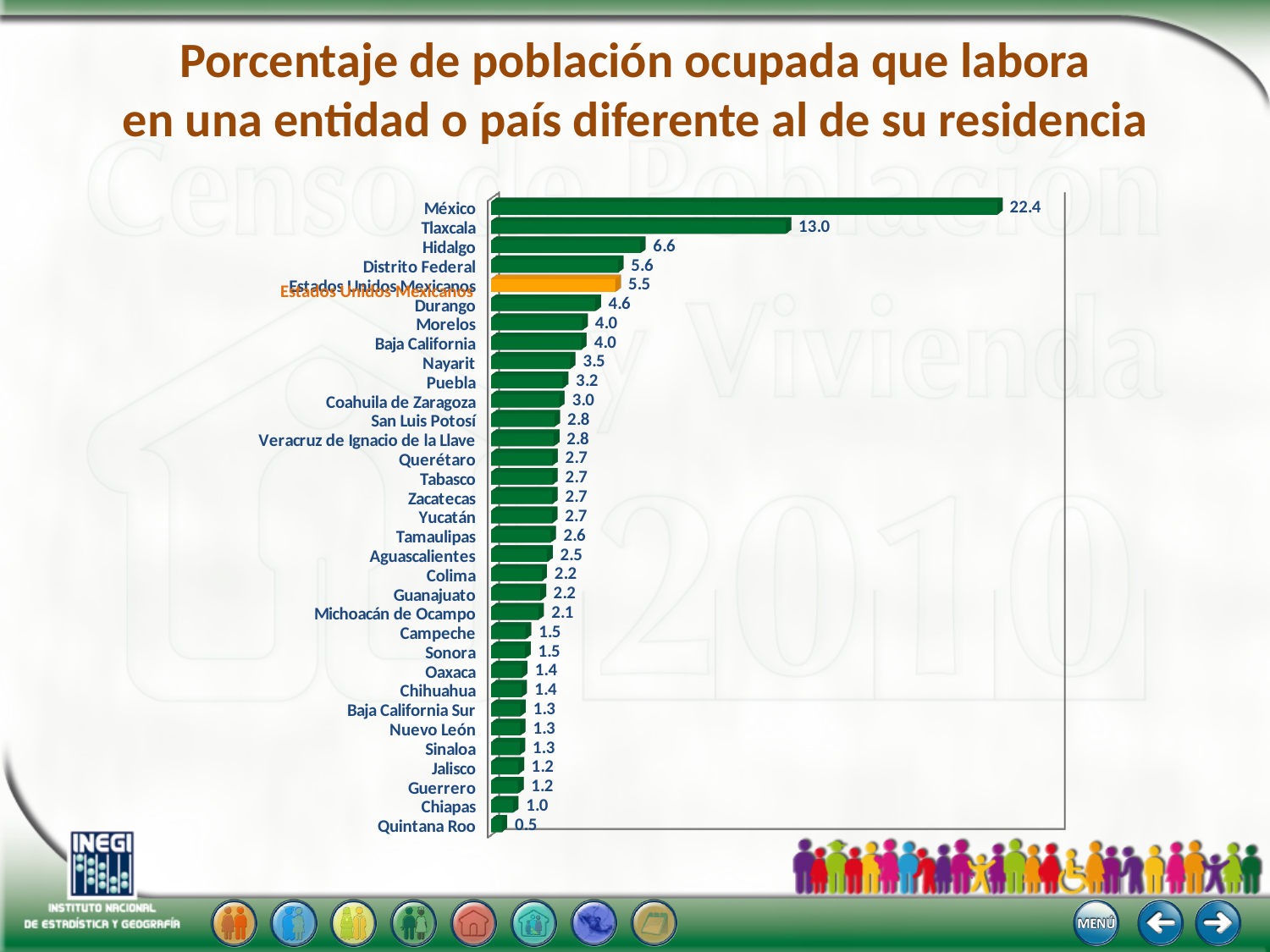
What is the value for México? 22.4 Which bar is coloured orange instead of green? Estados Unidos Mexicanos How many bars are shown in the chart? 33 What is the difference between the values for México and Tlaxcala? 9.4 What is the value for Tlaxcala? 13.0 What kind of chart is shown on the slide? Bar chart Which entity has the highest value? México What is the value for Estados Unidos Mexicanos, the orange bar? 5.5 Which has a larger value, Hidalgo or Distrito Federal? Hidalgo What is the value for Quintana Roo? 0.5 What is the value for Chiapas? 1.0 Which entity has the lowest value? Quintana Roo